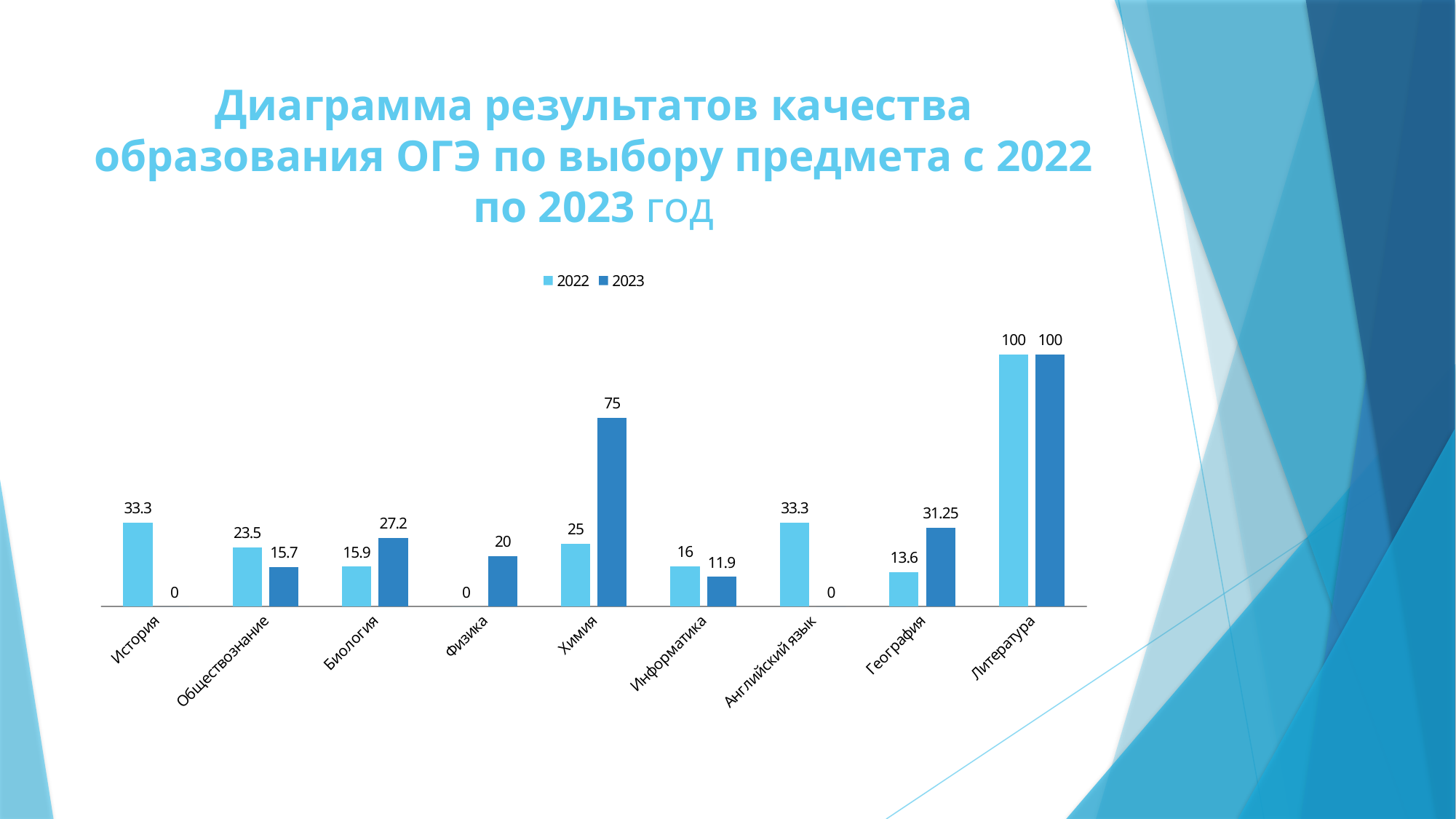
Which subject has the highest value in 2023? Литература Which is larger for Обществознание: the 2022 value or the 2023 value? 2022 How many subjects are shown on the x axis? 9 What is the value for География in 2023? 31.25 What is the difference between the 2023 and 2022 values for Химия? 50 What are the two series named in the legend? 2022 and 2023 What kind of chart is shown on the slide? Bar chart Which subject has the lowest non-zero value in 2022? География What is the value for История in 2022? 33.3 What is the value for Химия in 2023? 75 How many series does the legend list? 2 What is the value for Физика in 2022? 0